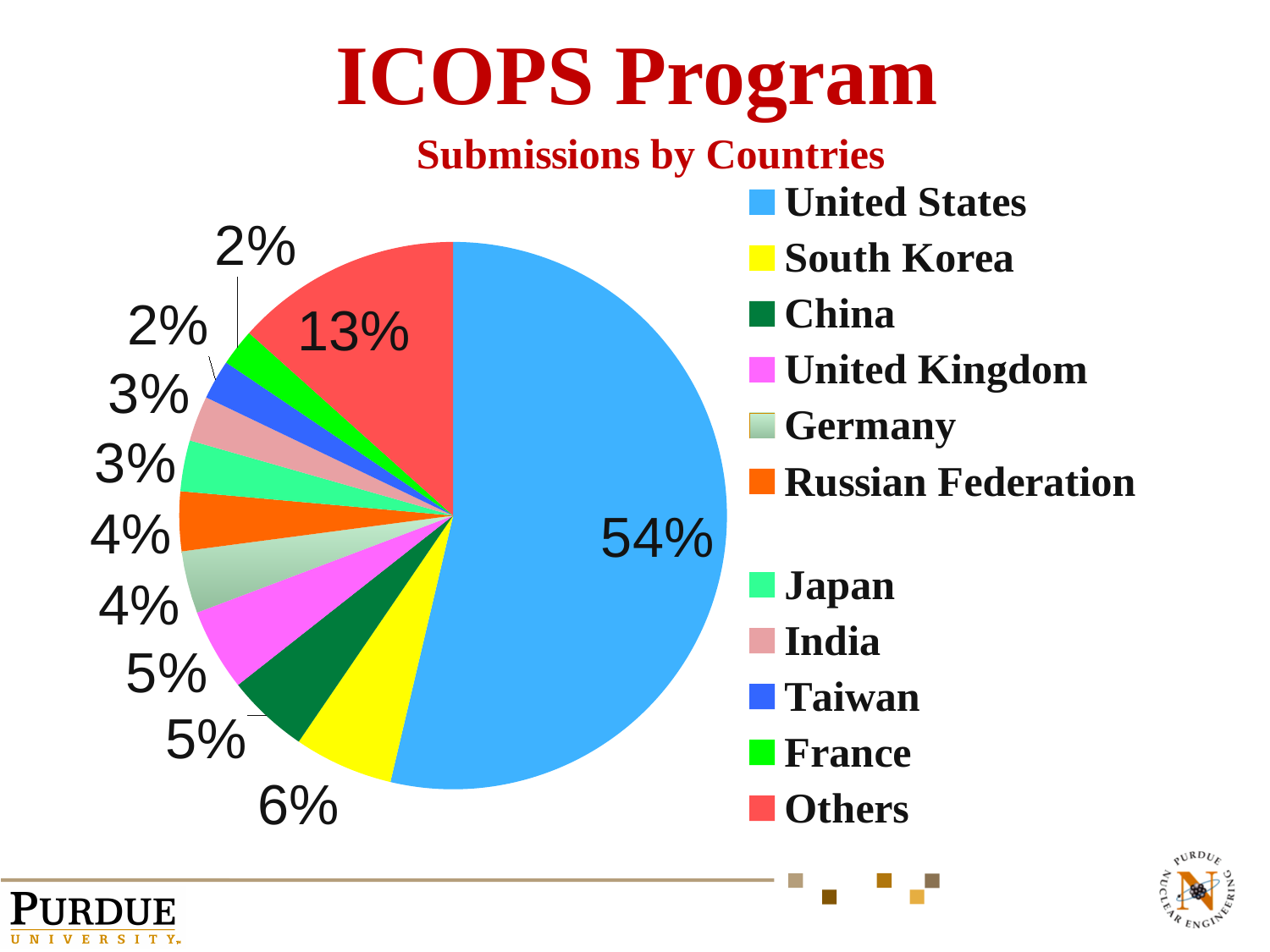
Which country has the largest share of submissions? United States Which has a larger share, Others or South Korea? Others What is the subtitle of the chart? Submissions by Countries What percentage of submissions is labelled for South Korea? 6% How many entries does the legend list? 11 What kind of chart is shown on the slide? Pie chart What is the difference in percentage points between the United States and Others? 41 What share of submissions does the United States account for? 54% What percentage is shown for Germany? 4% Which has a larger share, South Korea or China? South Korea What percentage is shown for France? 2% What share of submissions is shown for Others? 13%